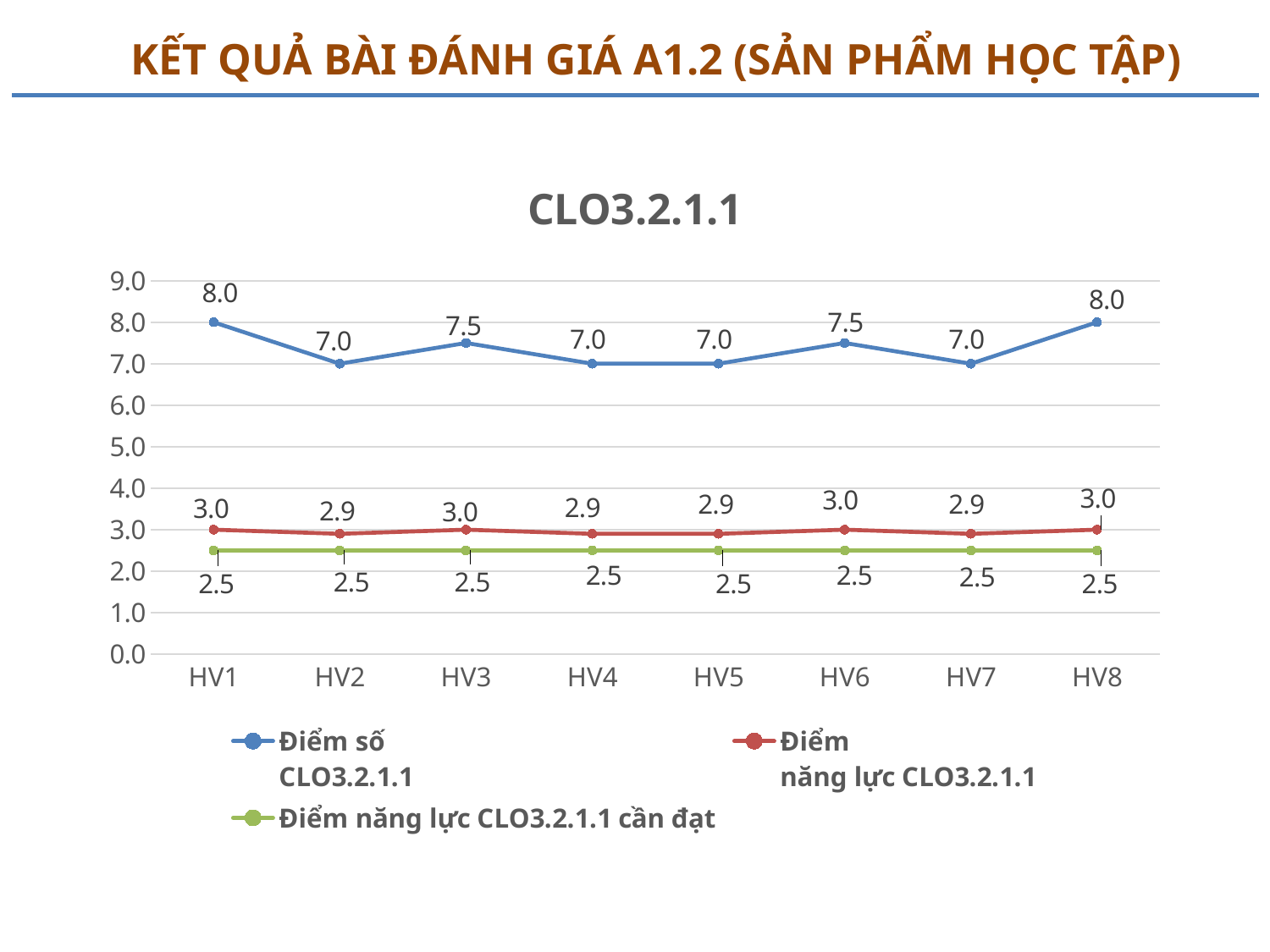
What is the value of Điểm năng lực CLO3.2.1.1 cần đạt for HV6? 2.5 How many categories are shown on the x axis? 8 What kind of chart is shown? line chart What is the value of Điểm năng lực CLO3.2.1.1 for HV4? 2.9 Is the value of Điểm số CLO3.2.1.1 for HV5 greater or less than 6.0? greater What is the value of Điểm số CLO3.2.1.1 for HV3? 7.5 What is the difference between the Điểm số CLO3.2.1.1 values for HV1 and HV2? 1.0 What is the value of Điểm số CLO3.2.1.1 for HV8? 8.0 Which category has the lowest value for Điểm số CLO3.2.1.1 among HV1, HV3 and HV4? HV4 What is the title of the chart? CLO3.2.1.1 How many series does the legend list? 3 Which is larger, the Điểm số CLO3.2.1.1 value for HV6 or for HV7? HV6